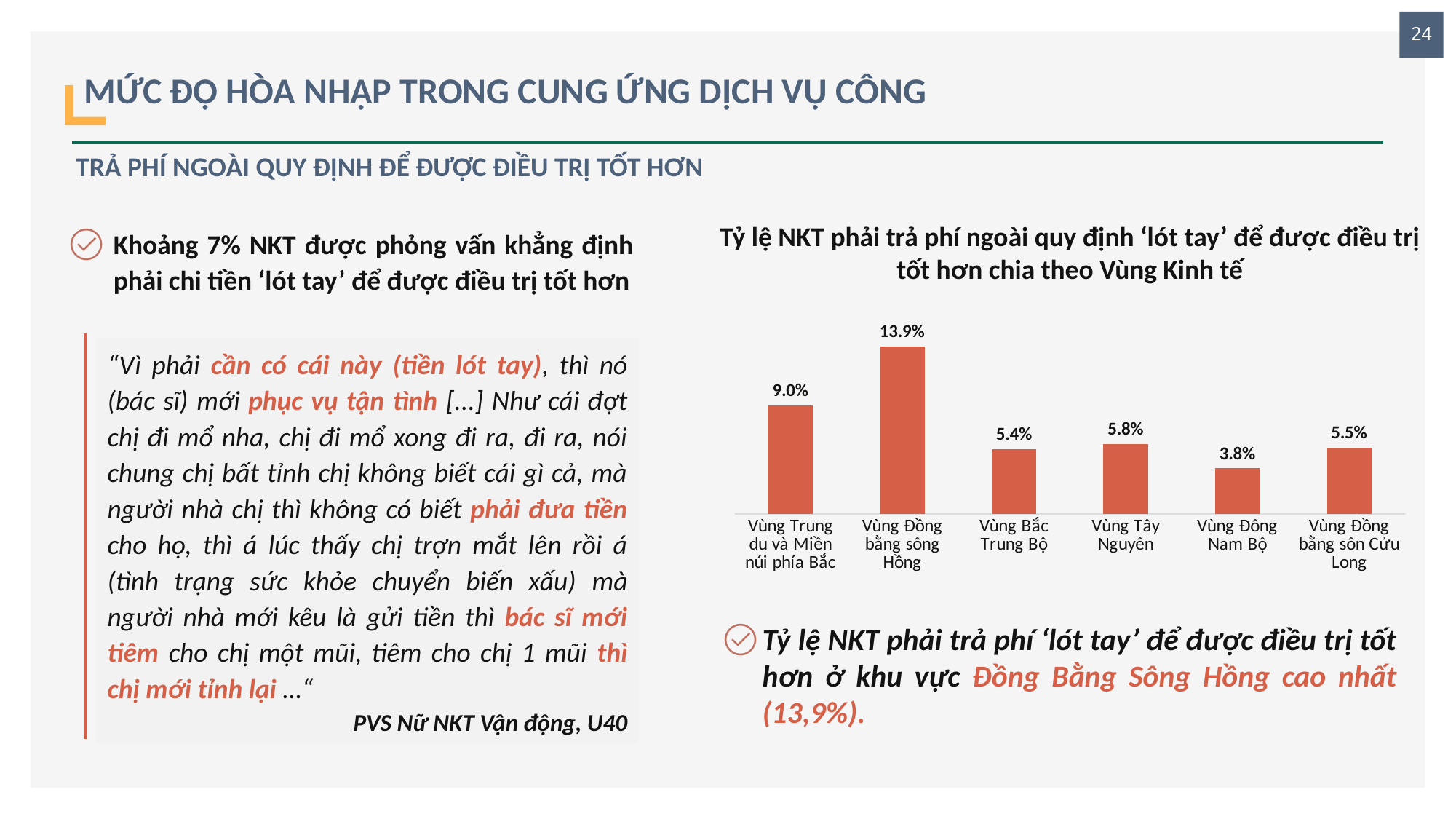
Which region has the lowest value in the chart? Vùng Đông Nam Bộ How many regions are shown in the chart? 6 What is the value for Vùng Tây Nguyên in the chart? 5.8% What kind of chart is shown on the slide? Bar chart What is the difference between the values for Vùng Đồng bằng sông Hồng and Vùng Trung du và Miền núi phía Bắc? 4.9% Which region has the highest value in the chart? Vùng Đồng bằng sông Hồng What is the value for Vùng Đông Nam Bộ in the chart? 3.8% Which is larger, the value for Vùng Bắc Trung Bộ or the value for Vùng Tây Nguyên? Vùng Tây Nguyên What is the value for Vùng Trung du và Miền núi phía Bắc in the chart? 9.0% What is the difference between the values for Vùng Tây Nguyên and Vùng Đông Nam Bộ? 2.0% What is the value for Vùng Đồng bằng sông Hồng in the chart? 13.9% What is the title of the chart? Tỷ lệ NKT phải trả phí ngoài quy định 'lót tay' để được điều trị tốt hơn chia theo Vùng Kinh tế